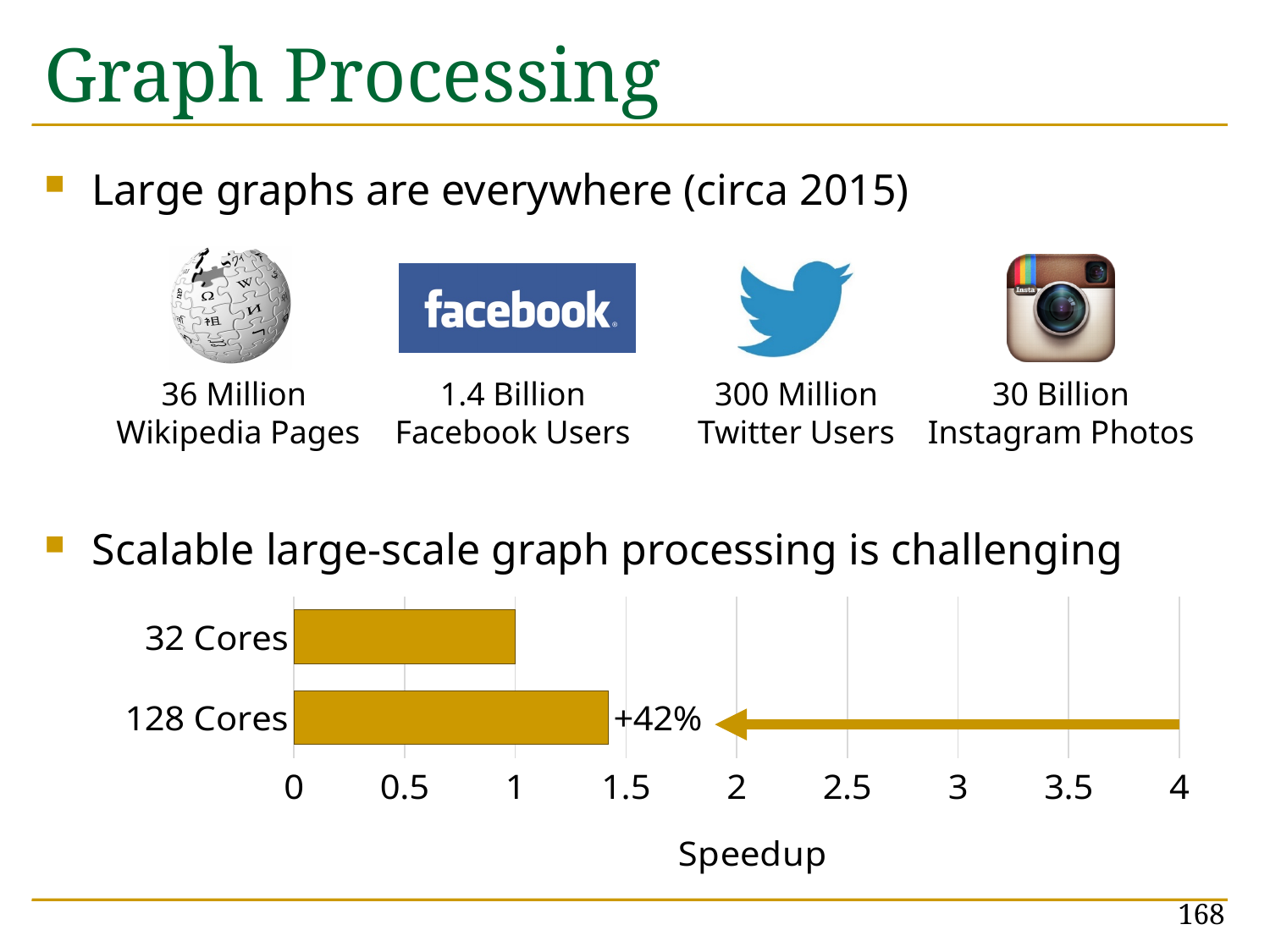
Which category has the highest speedup in the chart? 128 Cores What kind of chart is shown at the bottom of the slide? bar chart How many categories does the Speedup bar chart show? 2 What label is shown on the x axis of the bar chart? Speedup What is the speedup value for 32 Cores? 1 Is the speedup for 128 Cores greater or less than 2? less What annotation is printed next to the 128 Cores bar? +42% Is the speedup for 128 Cores greater or less than 1.5? less Which category has the higher speedup, 32 Cores or 128 Cores? 128 Cores What is the maximum value shown on the x axis of the bar chart? 4 Which category has the lowest speedup in the chart? 32 Cores Is the speedup for 128 Cores greater or less than 1? greater